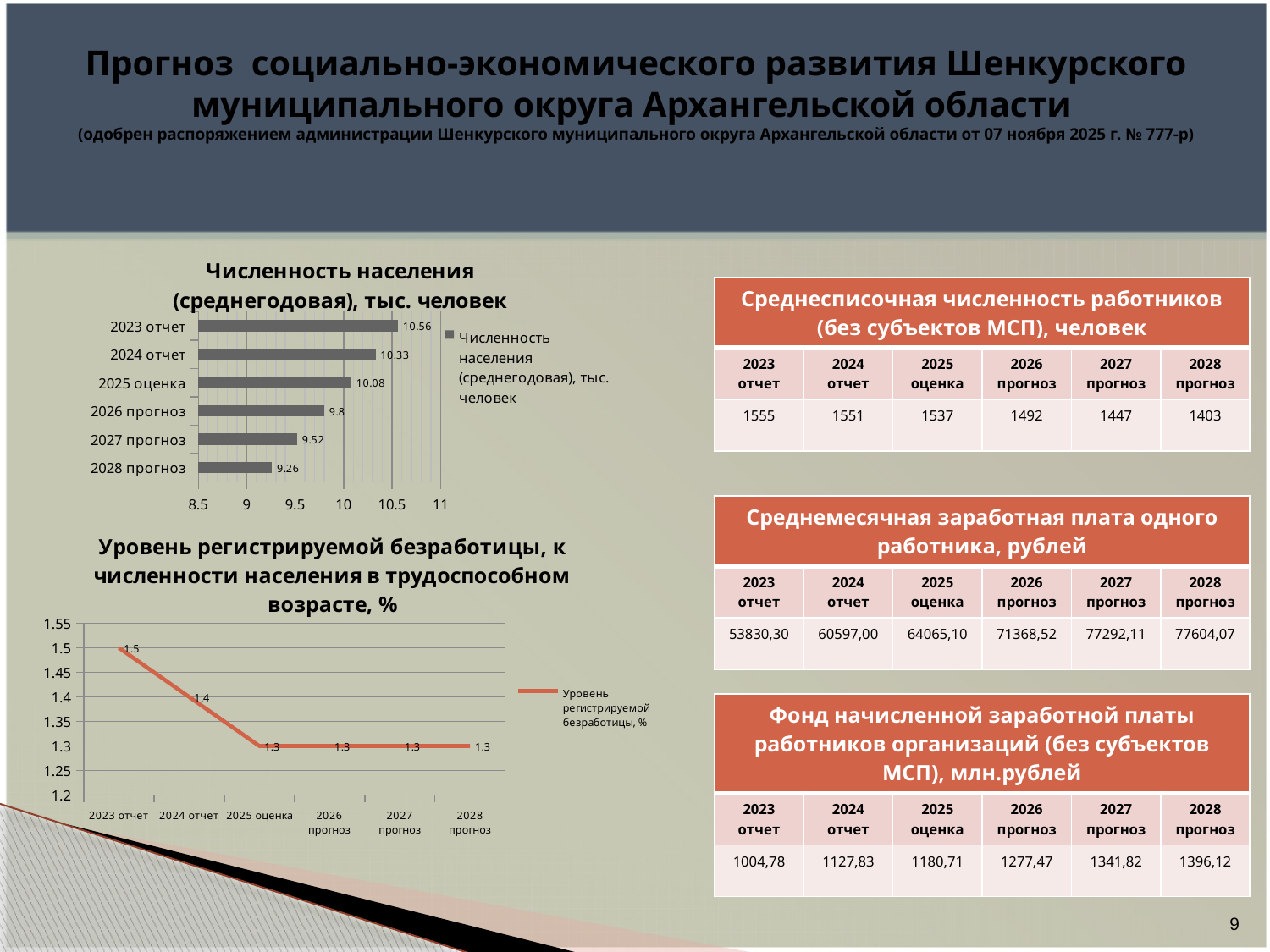
In the chart 'Уровень регистрируемой безработицы, к численности населения в трудоспособном возрасте, %', what is the value for 2028 прогноз? 1.3 In the chart 'Уровень регистрируемой безработицы, к численности населения в трудоспособном возрасте, %', what is the value for 2024 отчет? 1.4 In the chart 'Численность населения (среднегодовая), тыс. человек', what is the difference between the values for 2023 отчет and 2028 прогноз? 1.3 What type of chart is 'Уровень регистрируемой безработицы, к численности населения в трудоспособном возрасте, %'? Line chart In the chart 'Численность населения (среднегодовая), тыс. человек', how many categories are plotted? 6 In the chart 'Численность населения (среднегодовая), тыс. человек', which category has the lowest value? 2028 прогноз In the chart 'Численность населения (среднегодовая), тыс. человек', what is the value for 2026 прогноз? 9.8 In the chart 'Численность населения (среднегодовая), тыс. человек', what is the value for 2023 отчет? 10.56 What type of chart is 'Численность населения (среднегодовая), тыс. человек'? Bar chart In the chart 'Уровень регистрируемой безработицы, к численности населения в трудоспособном возрасте, %', do the values rise or fall from 2023 отчет to 2025 оценка? Fall In the chart 'Численность населения (среднегодовая), тыс. человек', which category has the highest value? 2023 отчет In the chart 'Уровень регистрируемой безработицы, к численности населения в трудоспособном возрасте, %', which is larger, the value for 2023 отчет or 2027 прогноз? 2023 отчет